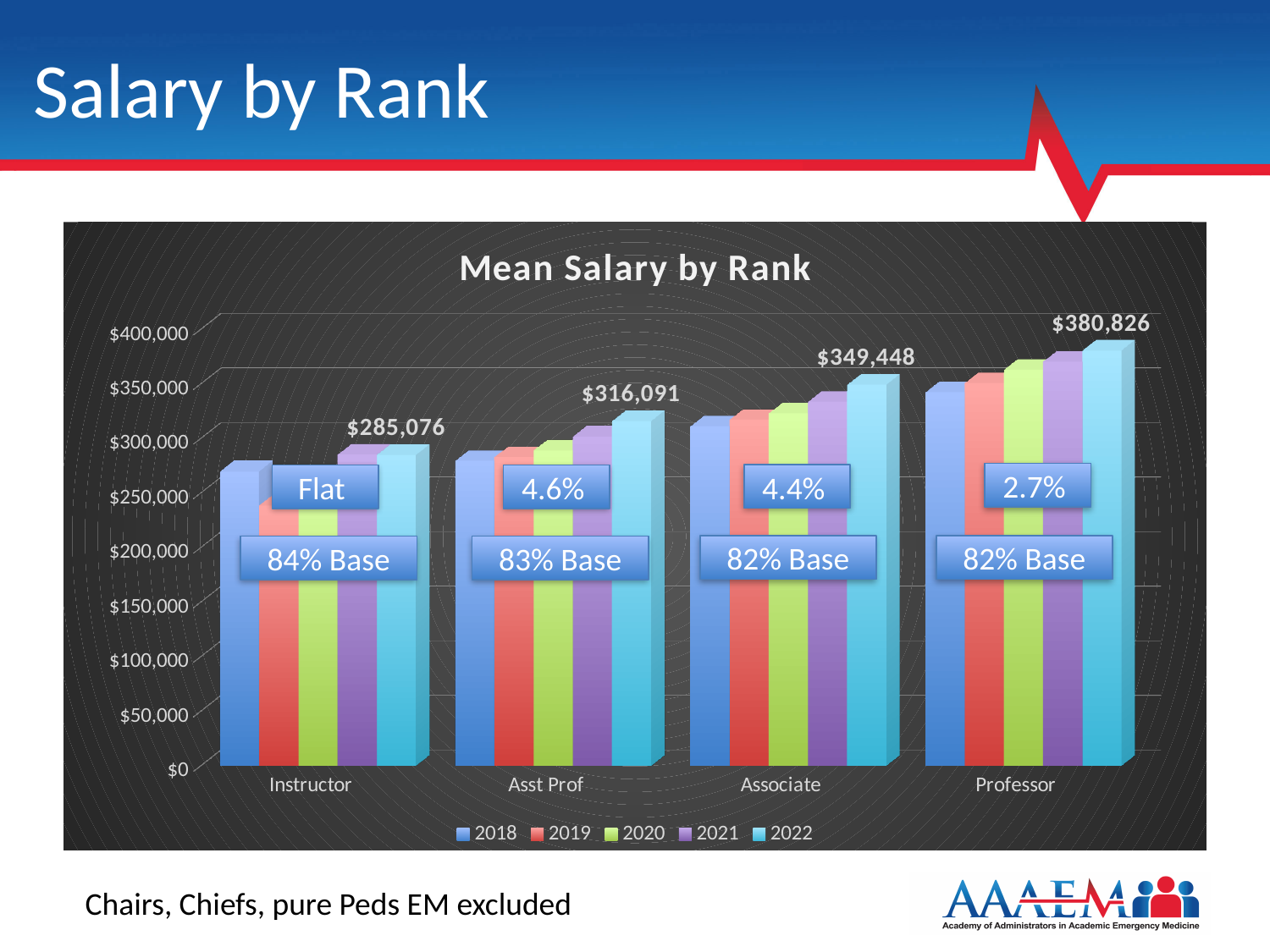
How many rank categories are shown on the x axis of the chart? 4 Do the labeled mean salaries rise or fall moving from Instructor to Professor along the x axis? Rise Which has the larger labeled value, Associate or Asst Prof? Associate Is the 2018 bar for Instructor greater or less than $300,000? less Is the 2018 bar for Professor greater or less than $300,000? greater What is the data label shown above the Asst Prof group in the Mean Salary by Rank chart? $316,091 What kind of chart is shown on the slide? Bar chart How many series does the legend of the chart list? 5 Which rank has the highest labeled mean salary in the chart? Professor Which rank has the lowest labeled mean salary in the chart? Instructor What is the difference between the labeled values for Professor ($380,826) and Associate ($349,448)? $31,378 What is the data label shown above the Professor group in the Mean Salary by Rank chart? $380,826